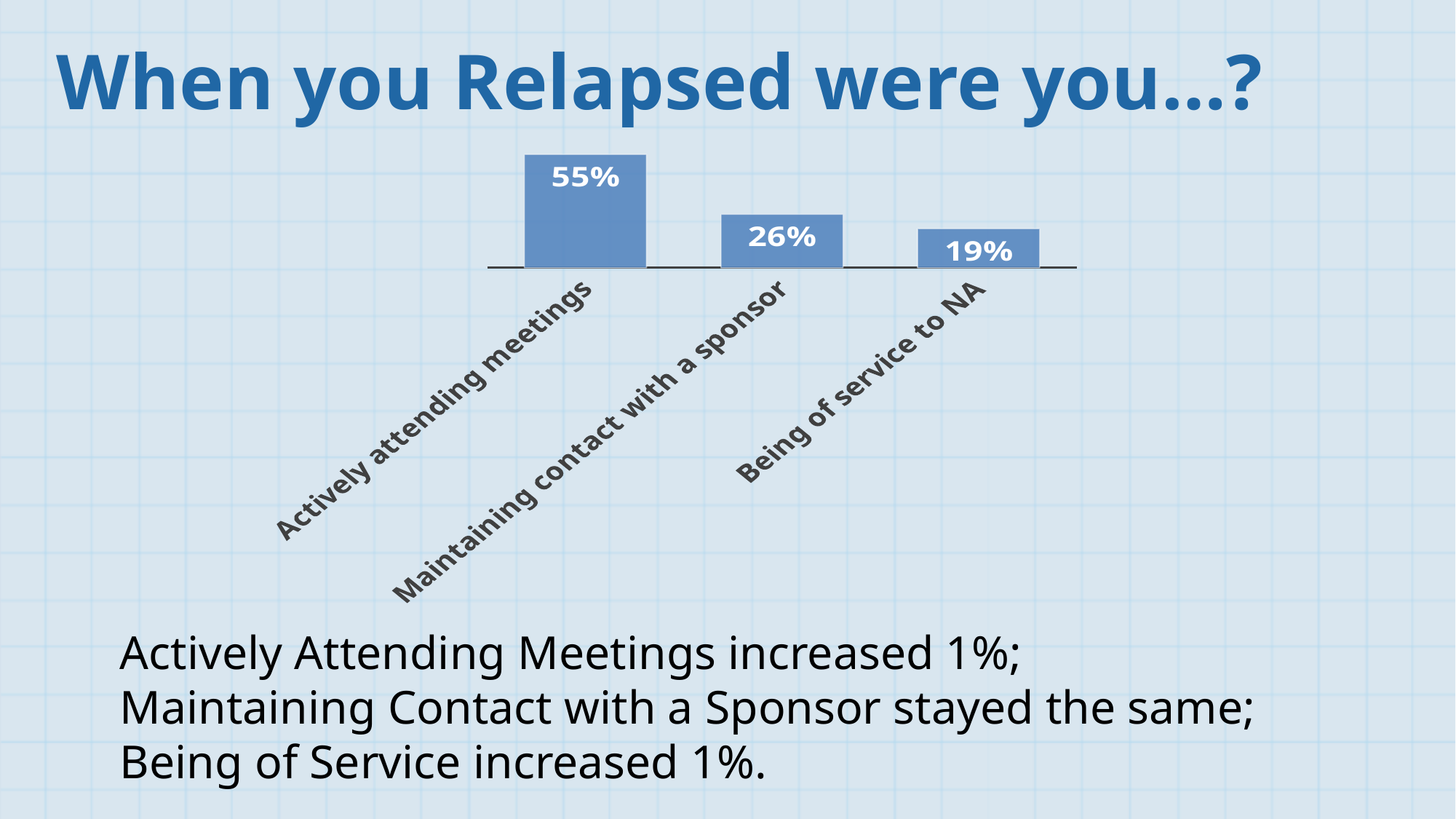
Which is larger, Maintaining contact with a sponsor or Being of service to NA? Maintaining contact with a sponsor Do the values rise or fall from left to right across the categories? Fall What is the difference between Actively attending meetings and Maintaining contact with a sponsor? 29% What kind of chart is shown on the slide? Bar chart What is the value for Maintaining contact with a sponsor? 26% What is the difference between Maintaining contact with a sponsor and Being of service to NA? 7% What is the value for Actively attending meetings? 55% What is the value for Being of service to NA? 19% How many categories are shown in the chart? 3 Which category has the highest value? Actively attending meetings What is the title of the slide containing the chart? When you Relapsed were you...? Which category has the lowest value? Being of service to NA